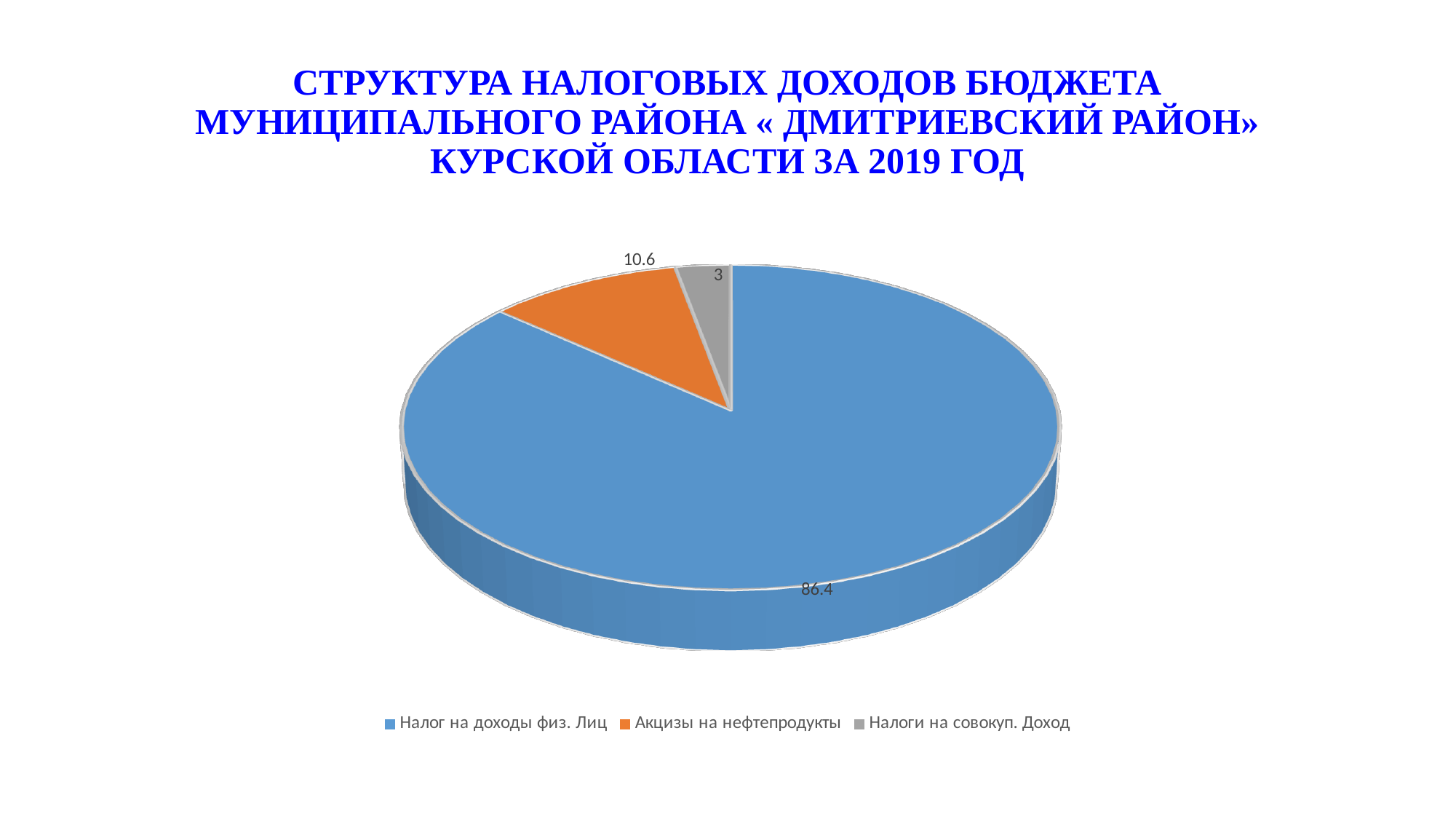
What colour is the slice for Акцизы на нефтепродукты? Orange Which category has the smallest slice? Налоги на совокуп. Доход What is the difference between the values for Акцизы на нефтепродукты and Налоги на совокуп. Доход? 7.6 What type of chart is shown on the slide? Pie chart How many categories does the pie chart have? 3 What is the value for Налоги на совокуп. Доход? 3 Which category has the largest slice? Налог на доходы физ. Лиц Which is larger: Акцизы на нефтепродукты or Налоги на совокуп. Доход? Акцизы на нефтепродукты What is the difference between the values for Налог на доходы физ. Лиц and Акцизы на нефтепродукты? 75.8 What is the value for Налог на доходы физ. Лиц? 86.4 How many entries does the legend list? 3 What is the value for Акцизы на нефтепродукты? 10.6